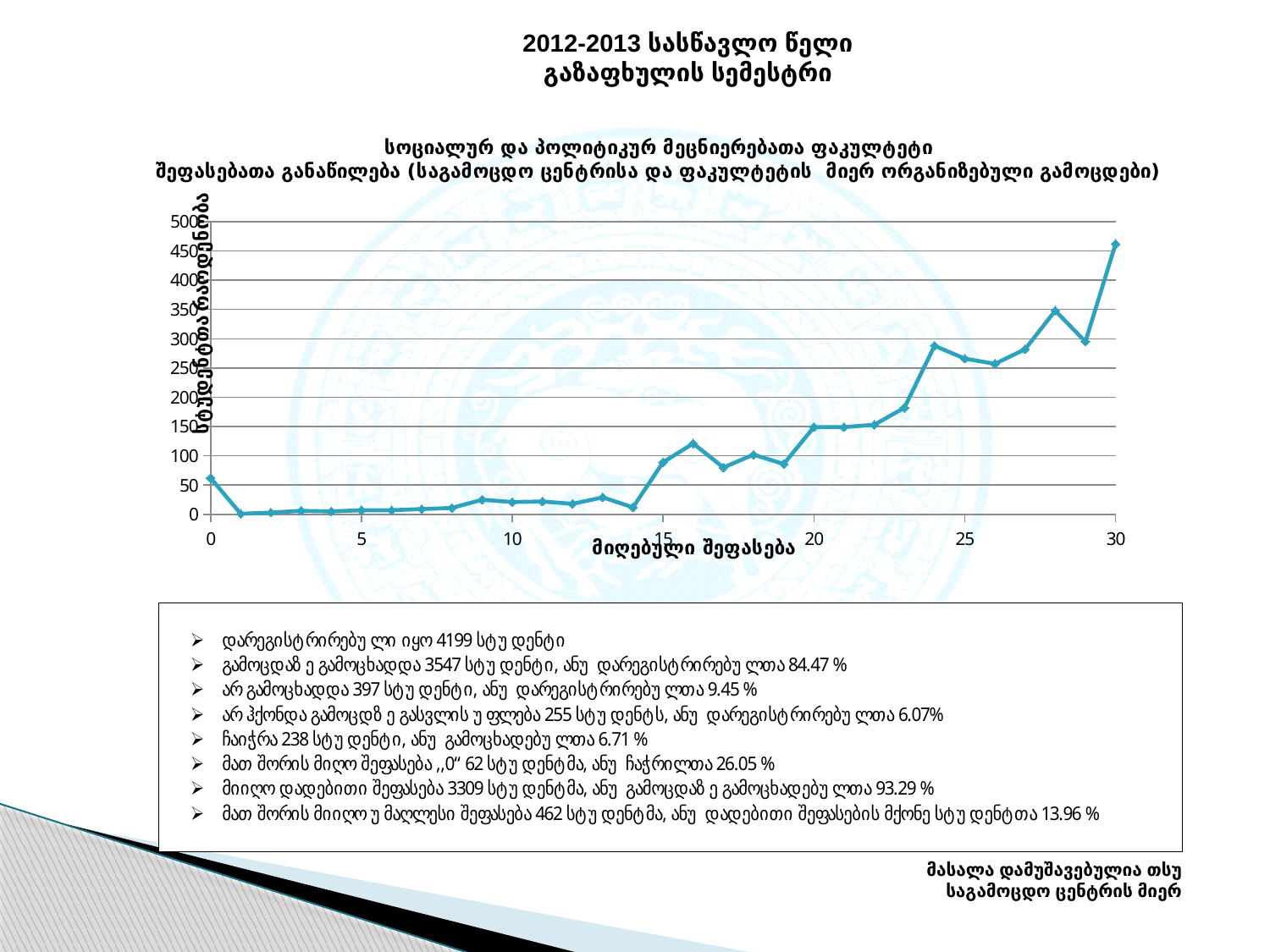
Is the number of students for score 10 greater or less than 50? less Which score (x-axis value) has the highest number of students? 30 Is the number of students for score 28 greater or less than 300? greater What kind of chart is shown on the slide? line chart What is the title of the y axis of the chart? სტუდენტთა რაოდენობა What is the title of the x axis of the chart? მიღებული შეფასება Which has more students, score 30 or score 28? 30 Which has more students, score 20 or score 10? 20 Is the number of students for score 30 greater or less than 400? greater Overall, do the values rise or fall as the score increases from 0 to 30? rise